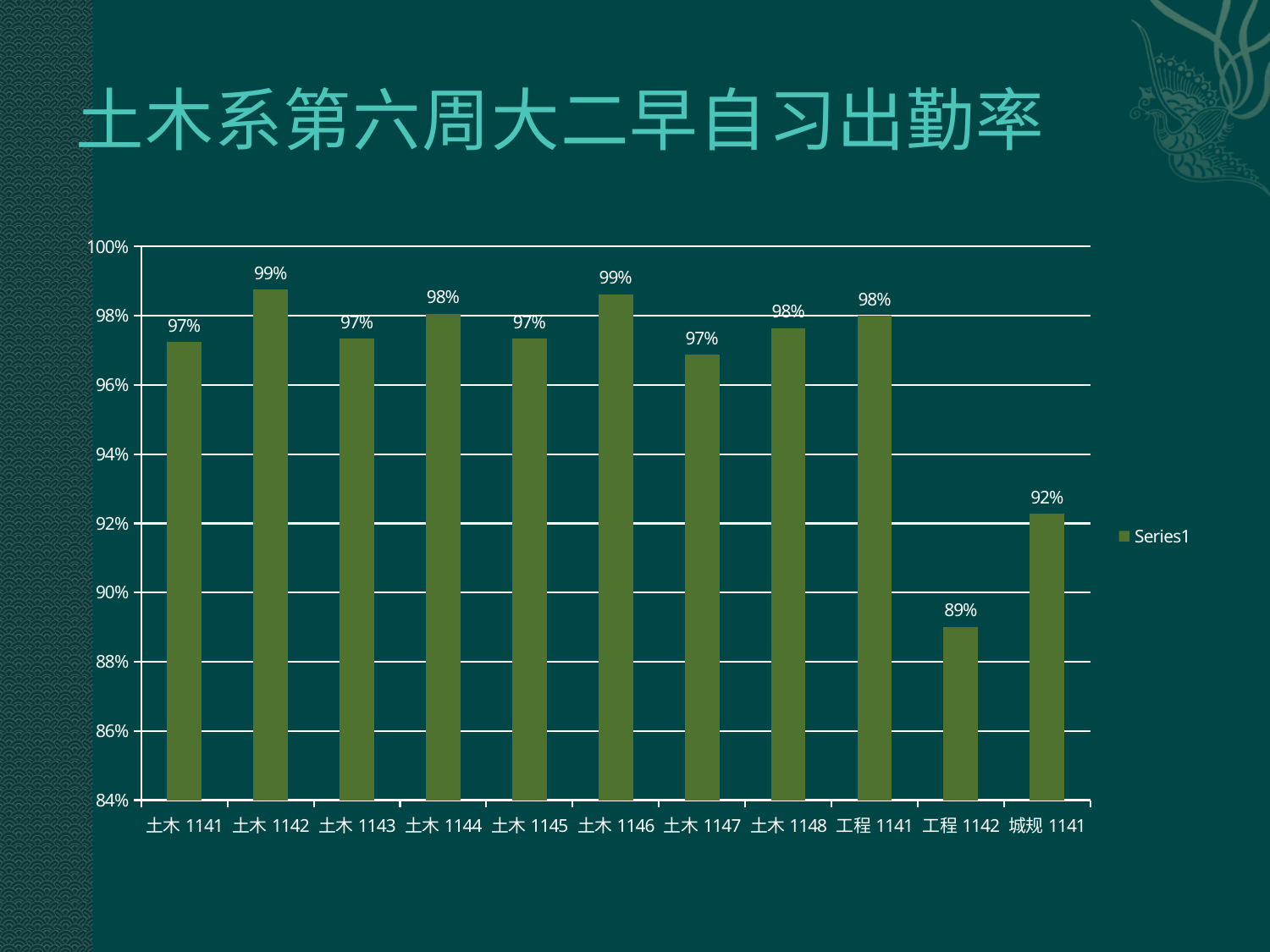
What is the value for 土木 1144? 98% Which is larger, the value for 土木 1146 or the value for 城规 1141? 土木 1146 What is the title of the slide? 土木系第六周大二早自习出勤率 What is the difference between the values for 城规 1141 and 工程 1142? 3% Is the value for 工程 1142 greater or less than 90%? less Which category has the lowest value? 工程 1142 What is the value for 土木 1142? 99% How many series does the legend list? 1 What kind of chart is shown on the slide? bar chart How many categories are shown on the x axis? 11 What is the value for 城规 1141? 92% What is the value for 工程 1142? 89%